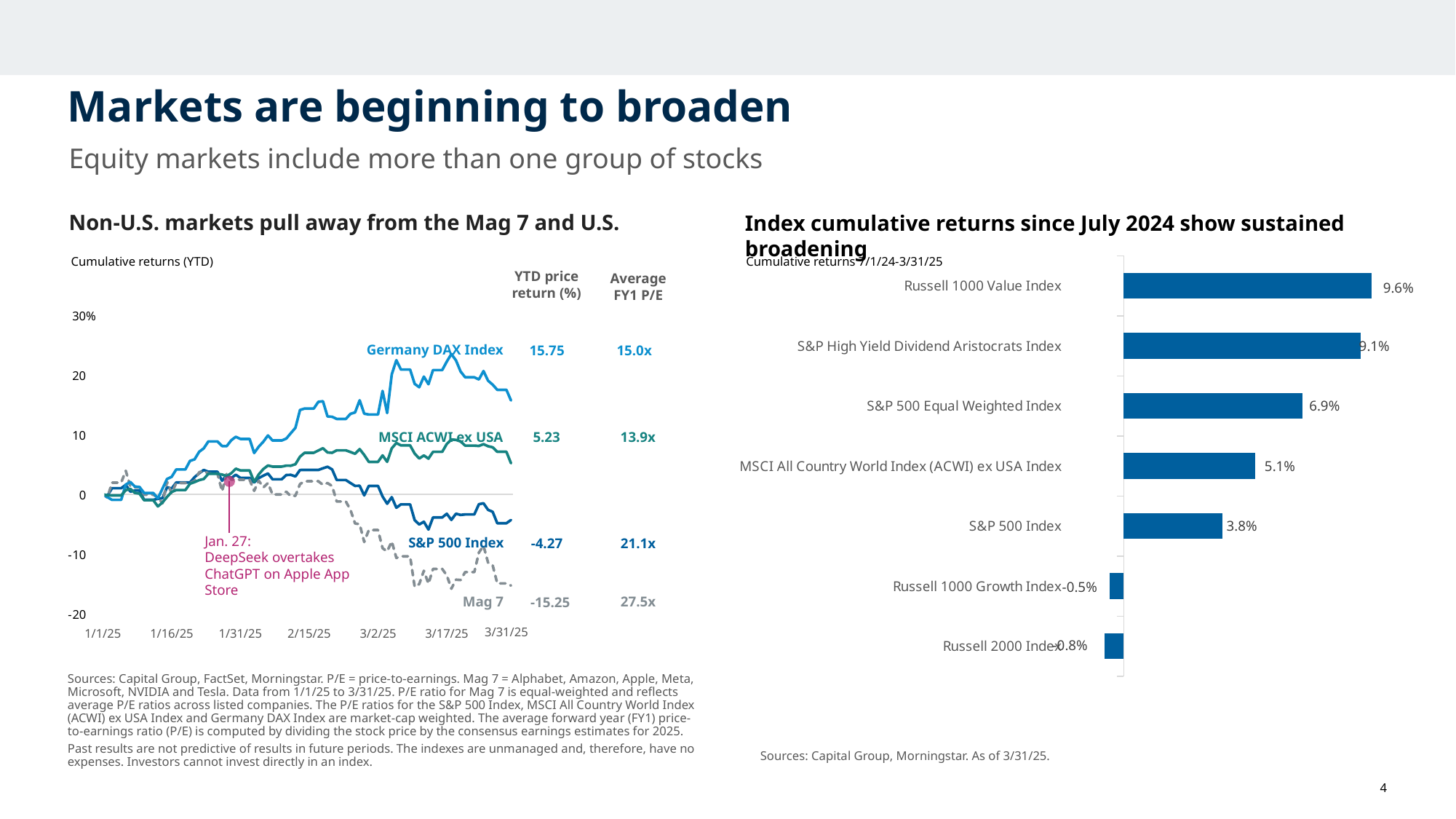
In the chart titled "Index cumulative returns since July 2024 show sustained broadening", how many indexes are shown? 7 In the chart titled "Non-U.S. markets pull away from the Mag 7 and U.S.", what event is annotated on Jan. 27? DeepSeek overtakes ChatGPT on Apple App Store In the chart titled "Index cumulative returns since July 2024 show sustained broadening", what type of chart is used? Bar chart In the chart titled "Non-U.S. markets pull away from the Mag 7 and U.S.", what is the average FY1 P/E for the Mag 7? 27.5x In the chart titled "Index cumulative returns since July 2024 show sustained broadening", what is the cumulative return for the Russell 1000 Growth Index? -0.5% In the chart titled "Index cumulative returns since July 2024 show sustained broadening", what is the difference between the S&P 500 Equal Weighted Index and the S&P 500 Index returns? 3.1% In the chart titled "Non-U.S. markets pull away from the Mag 7 and U.S.", what is the YTD price return (%) for the Germany DAX Index? 15.75 In the chart titled "Index cumulative returns since July 2024 show sustained broadening", which index has the lowest cumulative return? Russell 2000 Index In the chart titled "Non-U.S. markets pull away from the Mag 7 and U.S.", how many series are plotted? 4 In the chart titled "Index cumulative returns since July 2024 show sustained broadening", what is the cumulative return for the Russell 1000 Value Index? 9.6% In the chart titled "Non-U.S. markets pull away from the Mag 7 and U.S.", which series has the lowest YTD price return? Mag 7 In the chart titled "Index cumulative returns since July 2024 show sustained broadening", which index has the highest cumulative return? Russell 1000 Value Index